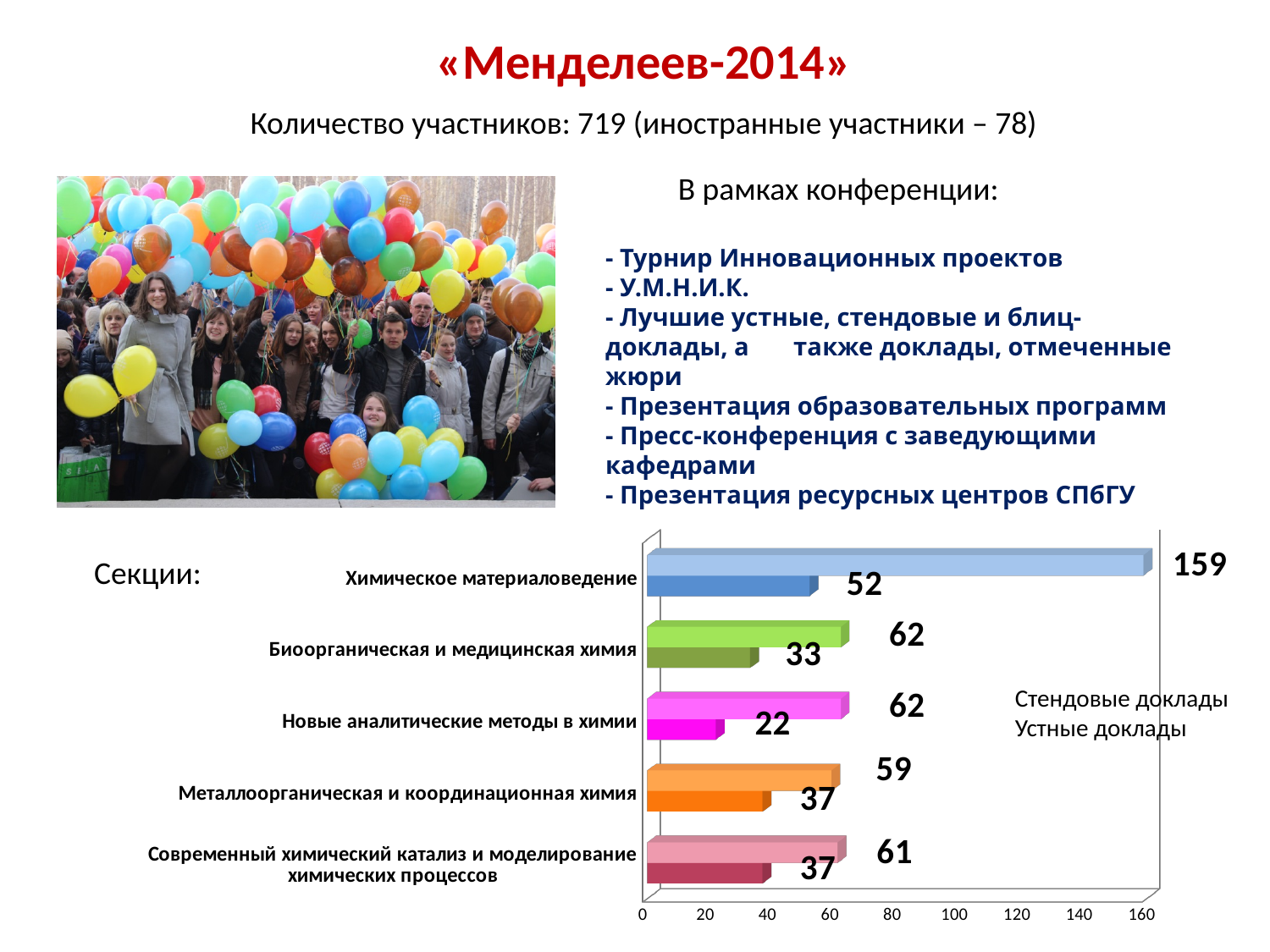
Which section has the lowest value shown in the chart? Новые аналитические методы в химии Which is larger: the upper bar for Биоорганическая и медицинская химия or the upper bar for Современный химический катализ и моделирование химических процессов? Биоорганическая и медицинская химия What are the two series named in the chart legend? Стендовые доклады, Устные доклады What type of chart is shown at the bottom of the slide? bar chart What is the value of the shorter (lower) bar for Новые аналитические методы в химии? 22 What is the value of the upper bar for Металлоорганическая и координационная химия? 59 Is the upper bar for Химическое материаловедение greater or less than 140? greater What is the value of the longer (upper) bar for Химическое материаловедение? 159 How many sections (categories) are shown in the bar chart? 5 Which section has the highest value in the chart? Химическое материаловедение What is the difference between the two bars for Химическое материаловедение (159 and 52)? 107 How many series does the chart's legend list? 2